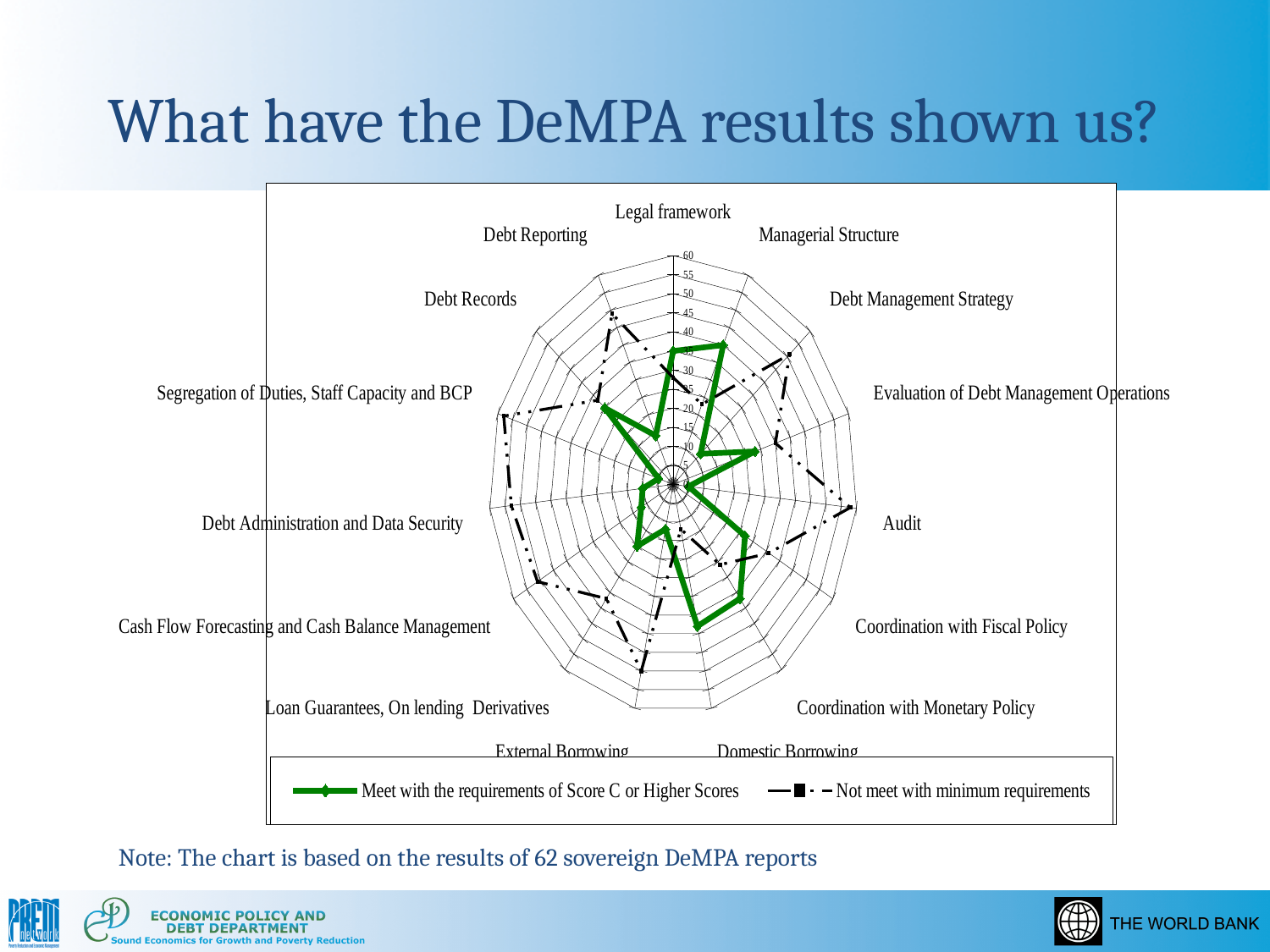
For Segregation of Duties, Staff Capacity and BCP, which series has the larger value: 'Meet with the requirements of Score C or Higher Scores' or 'Not meet with minimum requirements'? Not meet with minimum requirements Is the 'Not meet with minimum requirements' value for Audit greater or less than 40? greater For Audit, which series has the larger value: 'Meet with the requirements of Score C or Higher Scores' or 'Not meet with minimum requirements'? Not meet with minimum requirements Which series is drawn with the solid green line? Meet with the requirements of Score C or Higher Scores What kind of chart is shown on the slide? Radar chart Is the 'Not meet with minimum requirements' value for Segregation of Duties, Staff Capacity and BCP greater or less than 40? greater How many categories (axes) does the radar chart have? 15 For Domestic Borrowing, which series has the larger value: 'Meet with the requirements of Score C or Higher Scores' or 'Not meet with minimum requirements'? Meet with the requirements of Score C or Higher Scores Is the 'Meet with the requirements of Score C or Higher Scores' value for Domestic Borrowing greater or less than 30? greater What is the maximum value shown on the chart's radial axis? 60 How many series does the chart legend list? 2